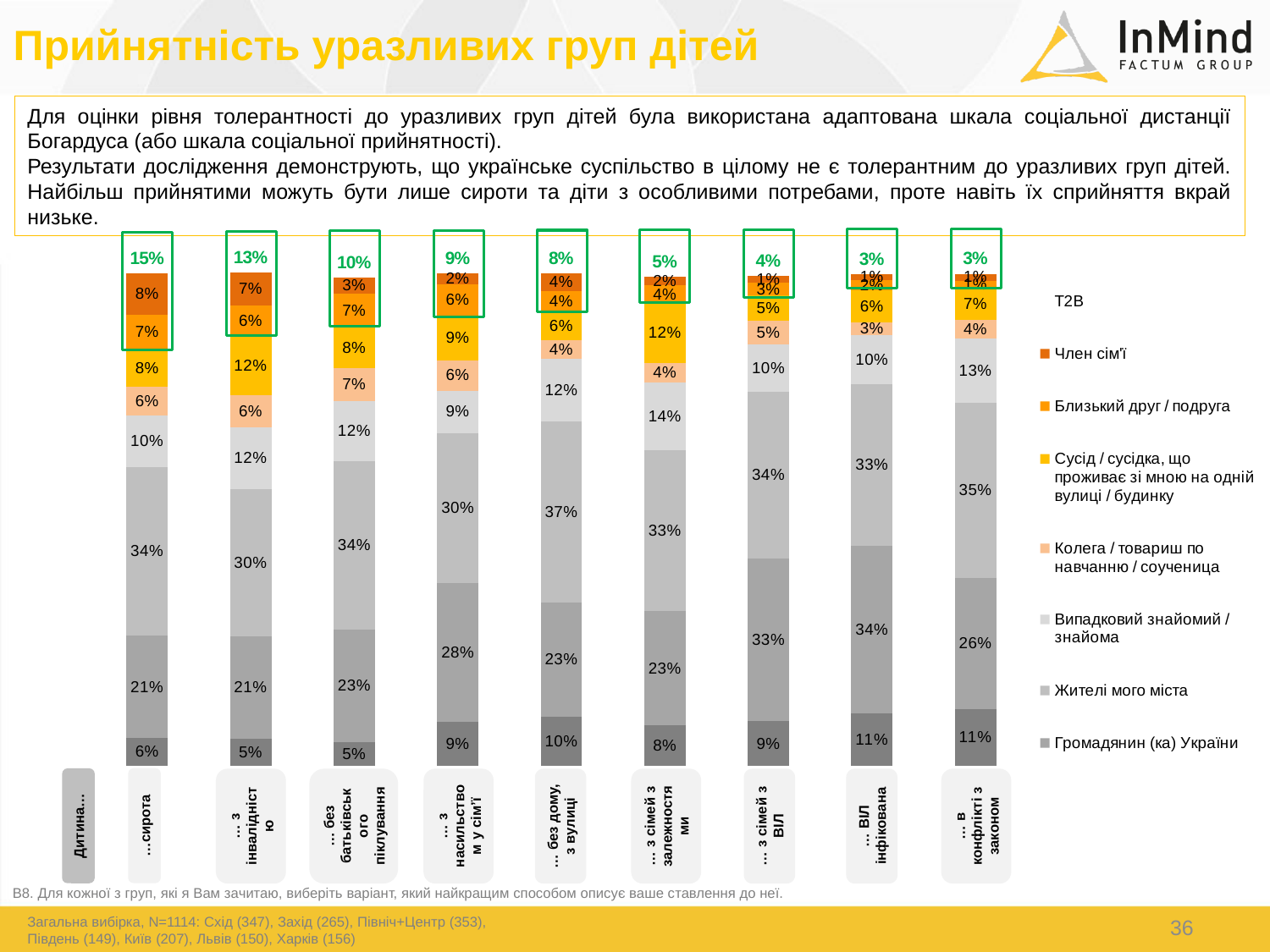
Do the T2B values rise or fall moving from left to right across the categories? Fall How many child-group categories are plotted on the x axis? 9 What is the T2B value shown for the category "…сирота"? 15% Which category has the highest T2B value? …сирота Which has the larger T2B value: "… без дому, з вулиці" or "… з сімей з залежностями"? … без дому, з вулиці What is the T2B value shown for the category "… ВІЛ інфікована"? 3% What is the title of the slide containing the chart? Прийнятність уразливих груп дітей What is the value of "Член сім'ї" for the category "… з інвалідністю"? 7% How many series does the legend list? 8 What kind of chart is shown on the slide? Stacked bar chart What is the value of "Член сім'ї" for the category "…сирота"? 8% What is the difference between the T2B values for "…сирота" and "… з інвалідністю"? 2 percentage points